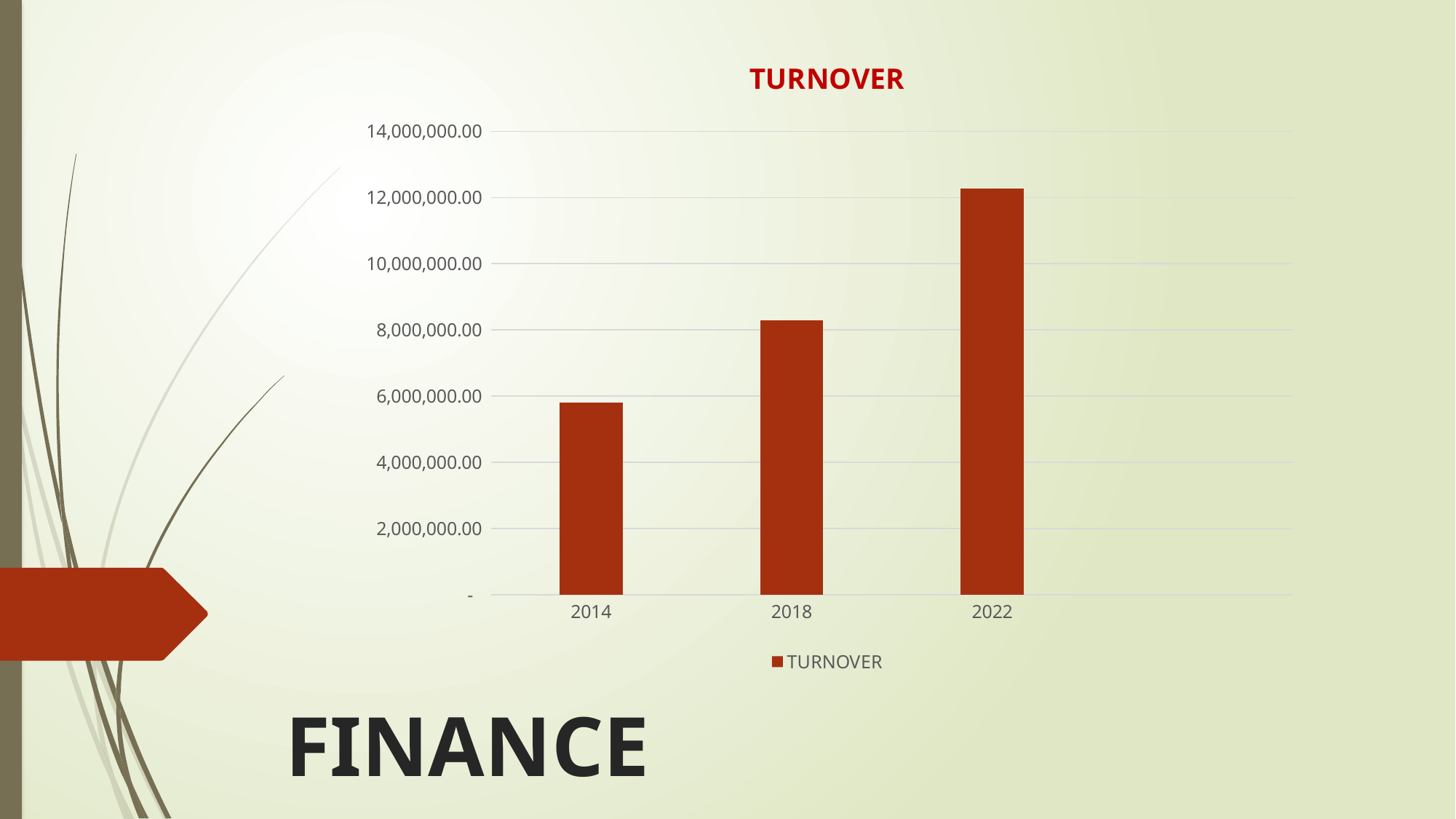
How many series does the legend list? 1 Does turnover rise or fall from 2014 to 2022? rise Which year has the larger turnover, 2014 or 2018? 2018 What series name is shown in the legend? TURNOVER Is the turnover for 2022 greater or less than 12,000,000.00? greater What kind of chart is shown on the slide? bar chart Is the turnover for 2014 greater or less than 6,000,000.00? less Which year has the highest turnover? 2022 How many years are shown on the x axis of the chart? 3 Which year has the lowest turnover? 2014 Is the turnover for 2018 greater or less than 8,000,000.00? greater What is the title of the chart? TURNOVER